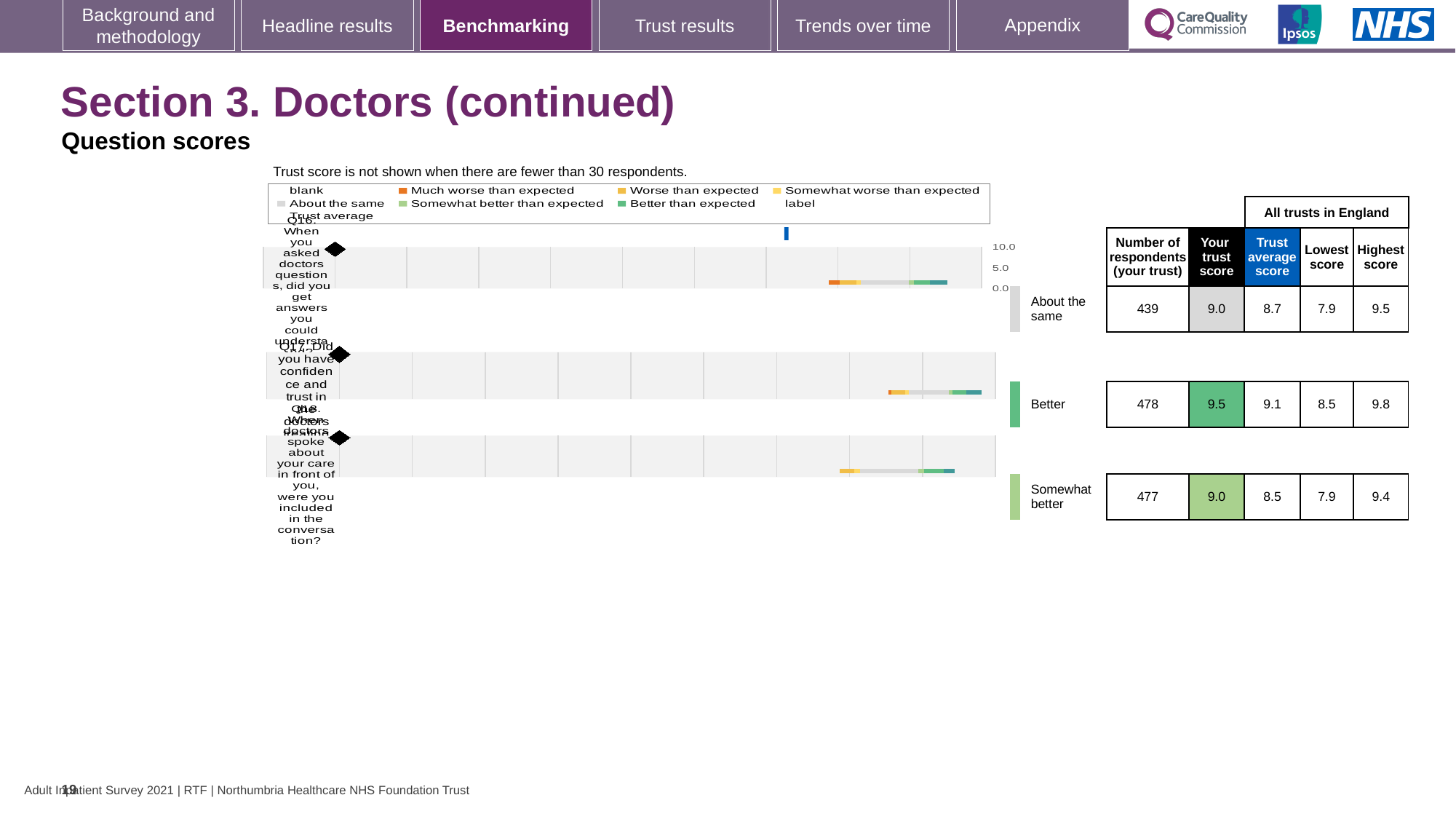
How many respondents from the trust answered Q16? 439 How many questions (categories) are plotted in the question scores chart? 3 What is the highest score among all trusts in England for Q17? 9.8 What is the trust's score for Q17 (confidence and trust in the doctors)? 9.5 Which benchmark category is the trust's Q17 score placed in? Better For Q16, which is larger: the trust's score or the trust average score? The trust's score (9.0) What is the lowest score among all trusts in England for Q18? 7.9 Which question has the highest trust score? Q17 What kind of chart is used to show the question scores on this slide? Bar chart According to the note above the chart, when is the trust score not shown? When there are fewer than 30 respondents What is the difference between the trust score and the trust average score for Q17? 0.4 Is the trust average score for Q16 greater or less than 5.0? greater